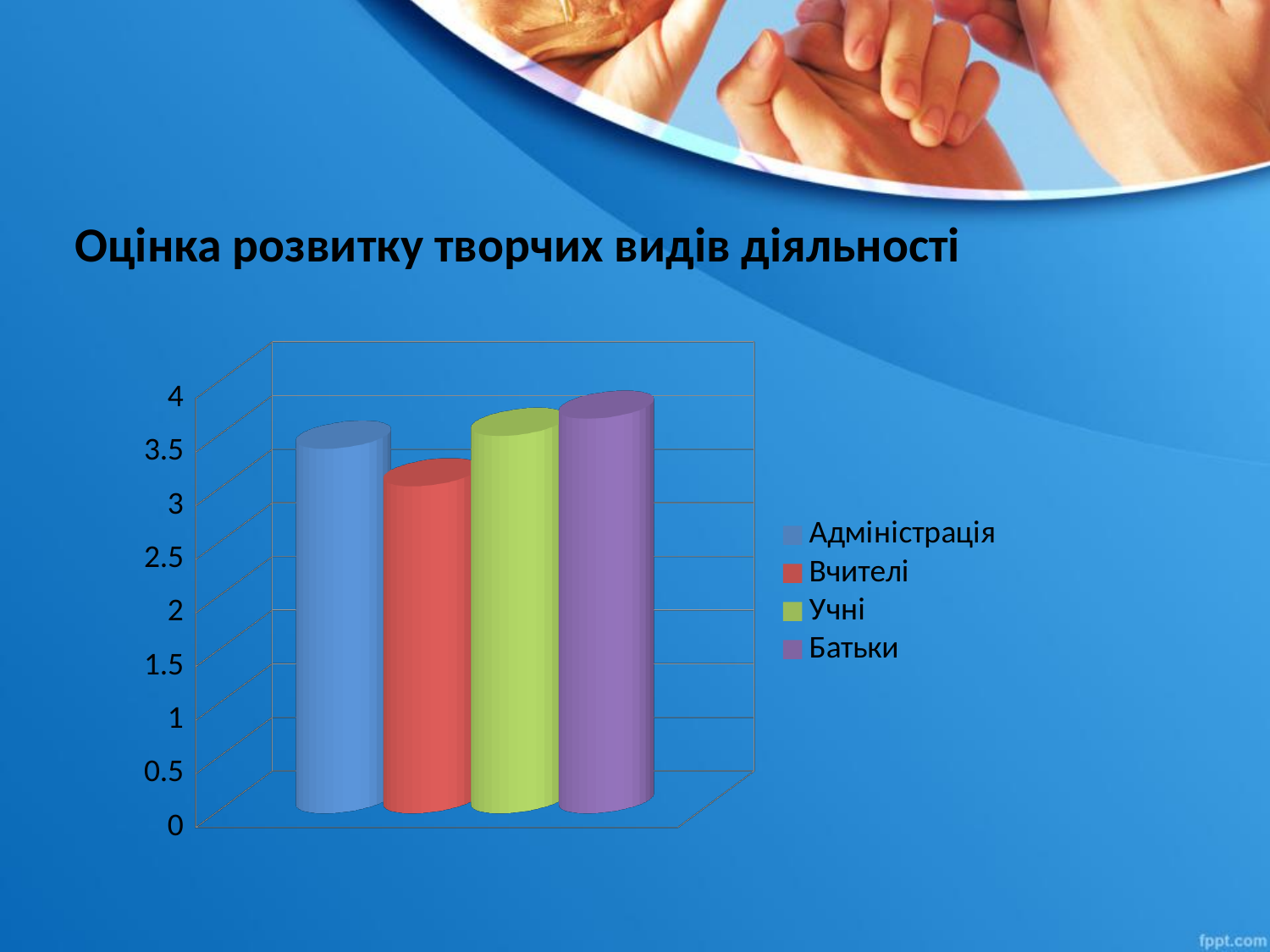
Is the value for Адміністрація greater or less than 3? greater Which is larger, the value for Батьки or the value for Адміністрація? Батьки Which is larger, the value for Батьки or the value for Вчителі? Батьки Is the value for Учні greater or less than 3? greater How many series does the legend list? 4 Which series has the lowest value? Вчителі Which is larger, the value for Учні or the value for Вчителі? Учні What kind of chart is shown on the slide? bar chart What colour represents Учні in the chart? green Is the value for Батьки greater or less than 3.5? greater What is the title of the slide's chart? Оцінка розвитку творчих видів діяльності